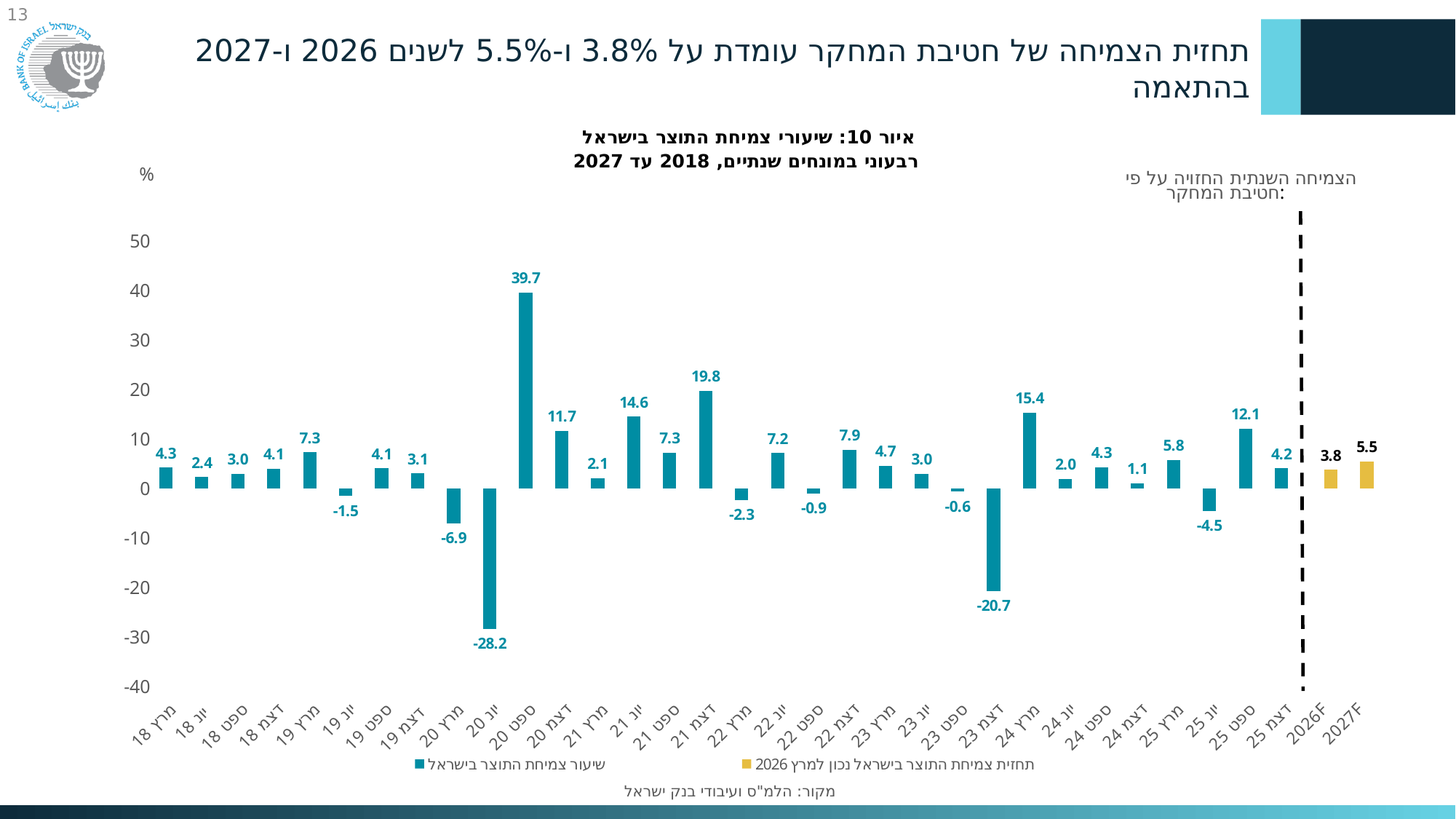
What is the value for דצמ 23 (December 2023)? -20.7 What colour are the bars for the 2026F and 2027F forecasts? yellow How many bars are plotted in the chart? 34 What is the difference between the 2027F and 2026F forecast values? 1.7 Which is larger, the value for דצמ 21 or the value for יונ 21? דצמ 21 Which period has the highest value in the chart? ספט 20 What type of chart is shown on the slide? bar chart Which period has the lowest value in the chart? יונ 20 What is the value for ספט 20 (September 2020)? 39.7 How many series does the legend list? 2 What is the forecast value for 2027F? 5.5 What is the value for יונ 20 (June 2020)? -28.2